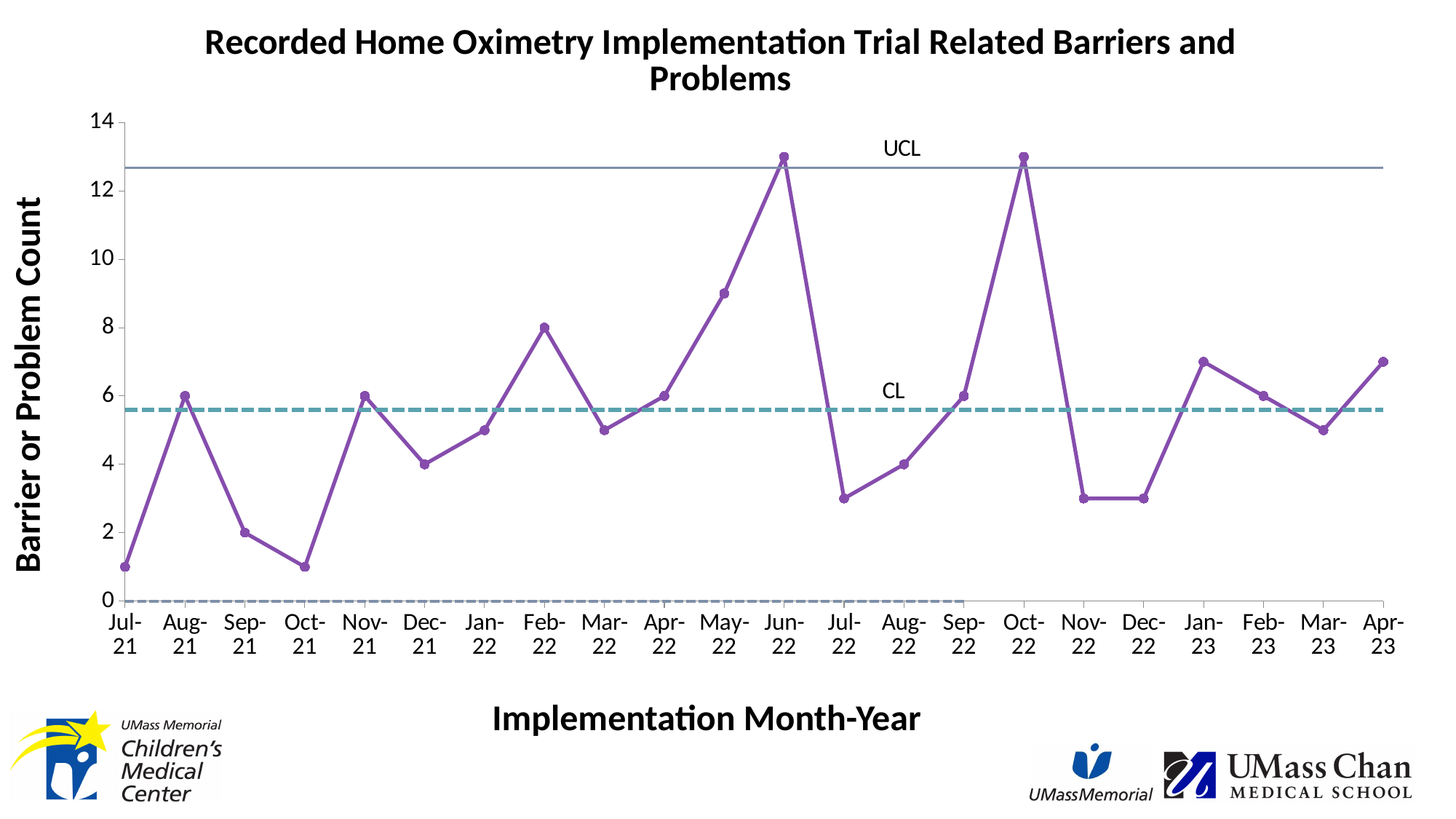
What is the barrier or problem count for Dec-21? 4 Is the value for Jun-22 greater or less than 12? greater What is the barrier or problem count for Sep-21? 2 What is the difference between the counts for Feb-22 and Dec-21? 4 What is the barrier or problem count for Aug-22? 4 Is the value for Jul-22 greater or less than 4? less How many months are plotted on the x axis? 22 Does the count rise or fall from Jun-22 to Jul-22? fall Which month has the larger count, Feb-22 or Dec-21? Feb-22 What is the label on the y axis? Barrier or Problem Count What kind of chart is shown on the slide? line chart What is the barrier or problem count for Feb-22? 8